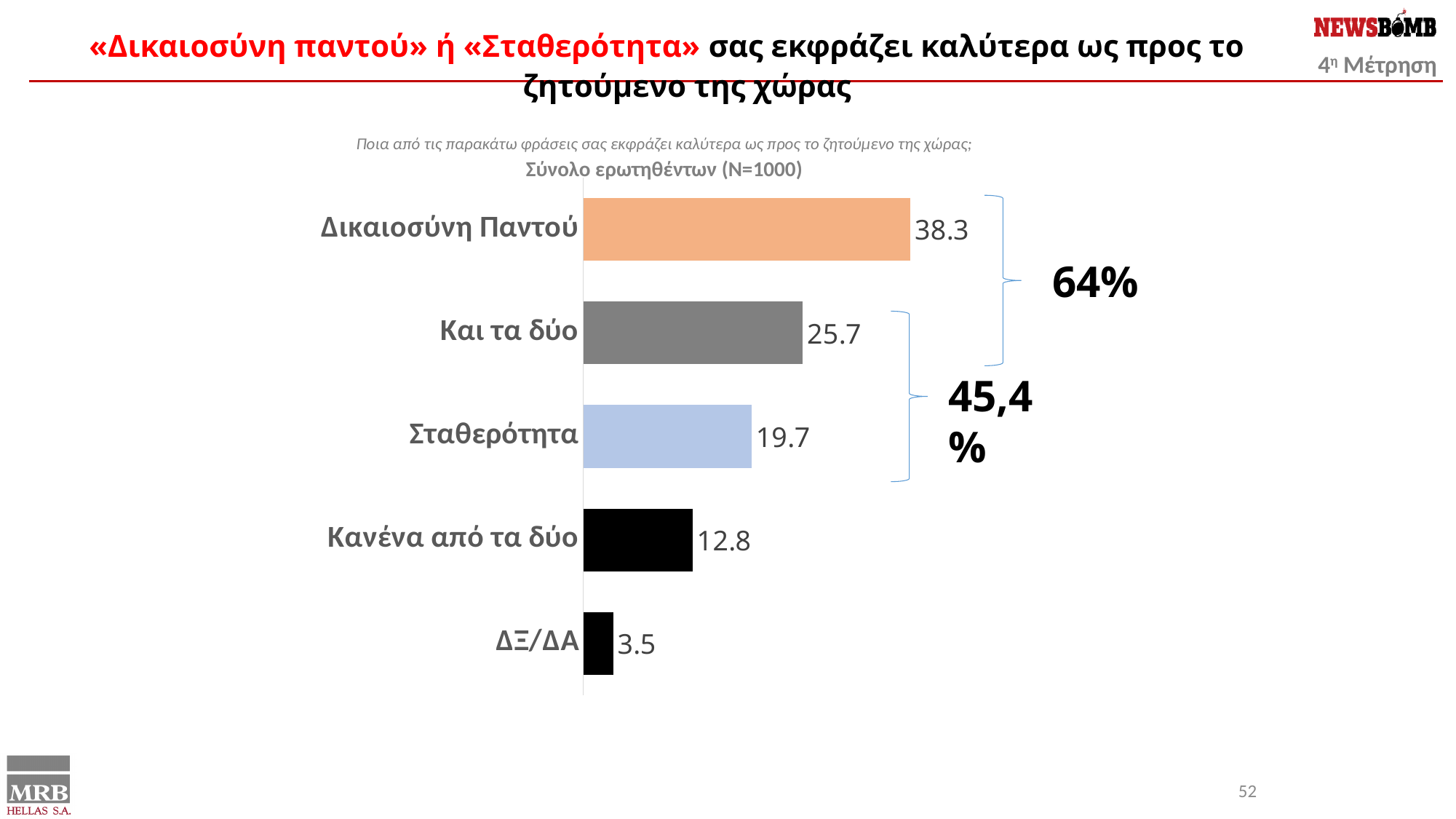
What is the value for Και τα δύο? 25.7 What is the value for ΔΞ/ΔΑ? 3.5 What kind of chart is shown on the slide? bar chart How many categories are shown in the chart? 5 What is the value for Κανένα από τα δύο? 12.8 What is the value for Δικαιοσύνη Παντού? 38.3 What percentage is shown next to the bracket grouping Δικαιοσύνη Παντού and Και τα δύο? 64% Which is larger, the value for Και τα δύο or the value for Κανένα από τα δύο? Και τα δύο Which category has the highest value? Δικαιοσύνη Παντού What is the difference between the values for Δικαιοσύνη Παντού and Σταθερότητα? 18.6 What is the value for Σταθερότητα? 19.7 Which category has the lowest value? ΔΞ/ΔΑ